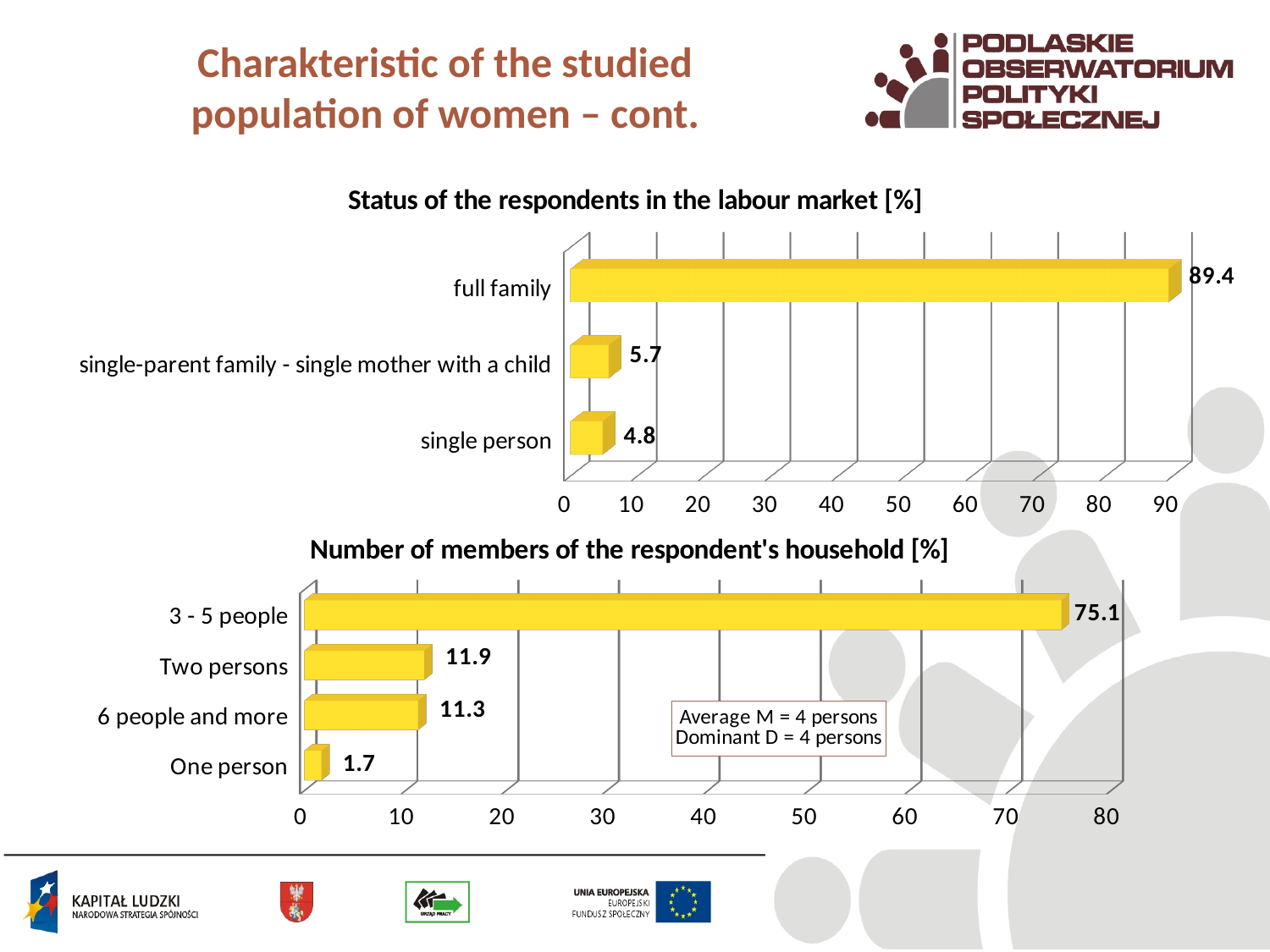
In the chart 'Status of the respondents in the labour market [%]', what is the difference between 'full family' and 'single-parent family - single mother with a child'? 83.7 In the chart 'Status of the respondents in the labour market [%]', what is the value for 'single person'? 4.8 What kind of chart is 'Number of members of the respondent's household [%]'? bar chart According to the text box in the chart 'Number of members of the respondent's household [%]', what is the average M? 4 persons In the chart 'Status of the respondents in the labour market [%]', which category has the lowest value? single person In the chart 'Number of members of the respondent's household [%]', which category has the highest value? 3 - 5 people In the chart 'Number of members of the respondent's household [%]', what is the value for 'Two persons'? 11.9 In the chart 'Status of the respondents in the labour market [%]', what is the value for 'full family'? 89.4 In the chart 'Number of members of the respondent's household [%]', what is the difference between '3 - 5 people' and 'Two persons'? 63.2 In the chart 'Number of members of the respondent's household [%]', which is larger: 'Two persons' or '6 people and more'? Two persons In the chart 'Status of the respondents in the labour market [%]', how many categories are shown? 3 In the chart 'Number of members of the respondent's household [%]', what is the value for 'One person'? 1.7